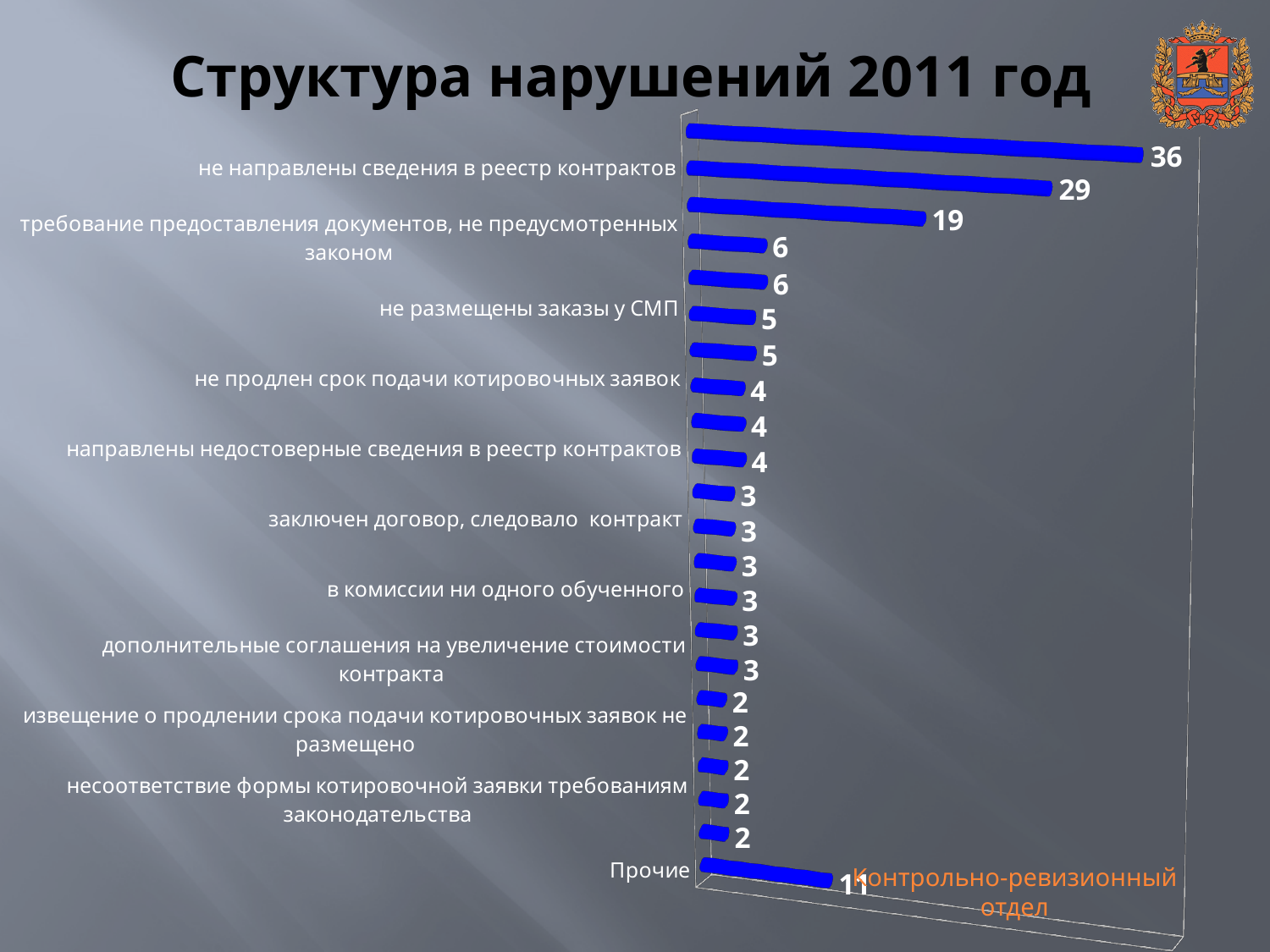
What is the difference between the highest value (36) and the second-highest value (29)? 7 What colour are the bars on the chart? blue How many bars on the chart have the value 2? 5 What is the third-highest value shown on the chart? 19 What is the highest value shown on the chart? 36 What is the lowest value shown on the chart? 2 What is the second-highest value shown on the chart? 29 What is the title of the chart? Структура нарушений 2011 год How many bars are plotted on the chart? 22 What kind of chart is shown on the slide? bar chart What is the difference between the highest value (36) and the third-highest value (19)? 17 How many bars on the chart have the value 3? 6